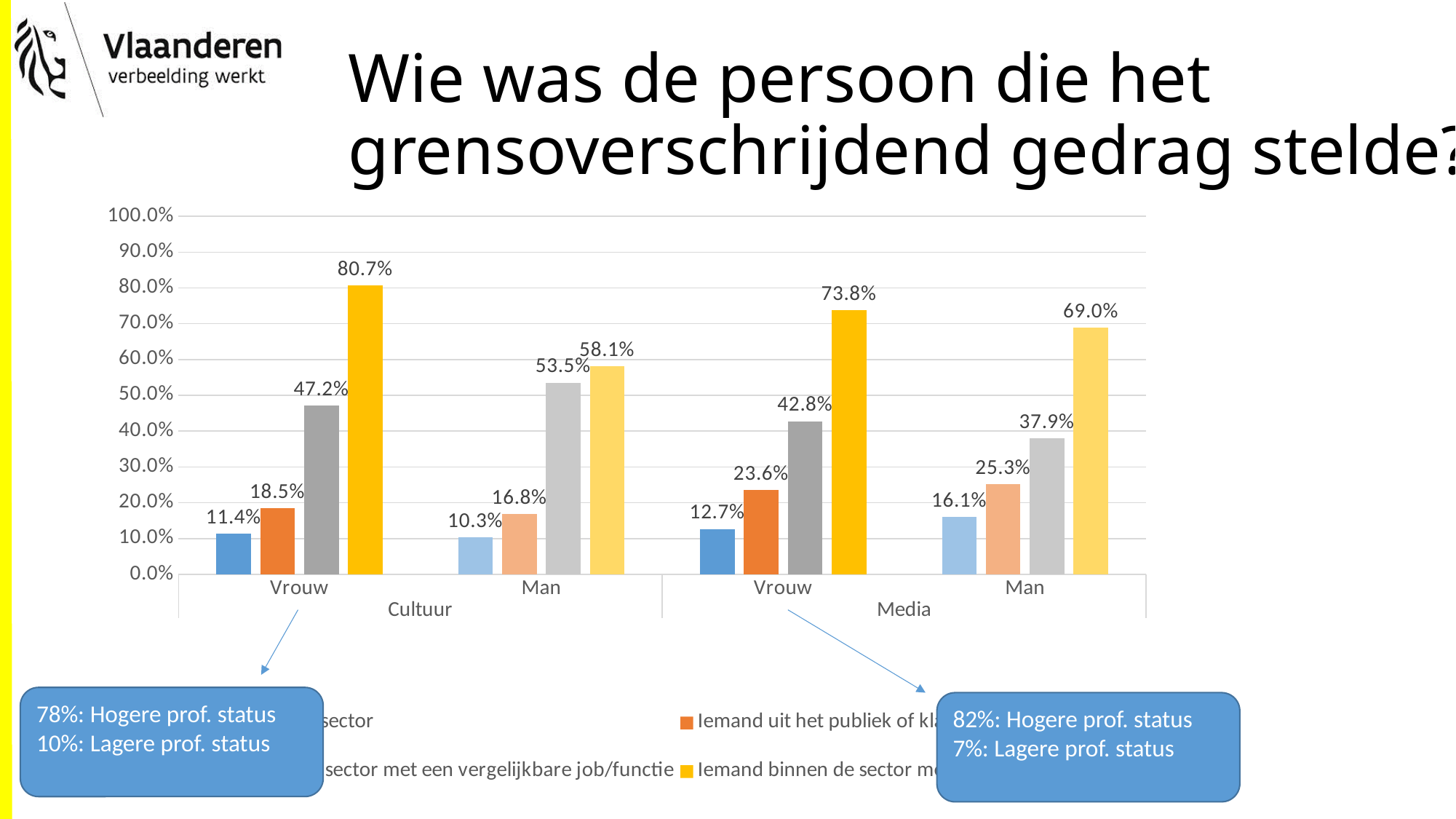
How many Vrouw/Man category groups are shown along the x axis? 4 What is the value of the orange bar for Man in the Media sector? 25.3% Is the value of the yellow bar for Man in the Media sector greater or less than 60.0%? greater What kind of chart is shown on the slide? bar chart What is the highest value shown in the chart? 80.7% What is the lowest value shown in the chart? 10.3% What is the value of the yellow bar for Vrouw in the Media sector? 73.8% What is the difference between the yellow bar for Vrouw in Cultuur (80.7%) and the yellow bar for Vrouw in Media (73.8%)? 6.9 percentage points How many series does the legend list? 4 Which has the larger grey bar in the Cultuur sector, Vrouw or Man? Man What is the maximum value shown on the y axis? 100.0% What is the value of the grey bar for Man in the Cultuur sector? 53.5%